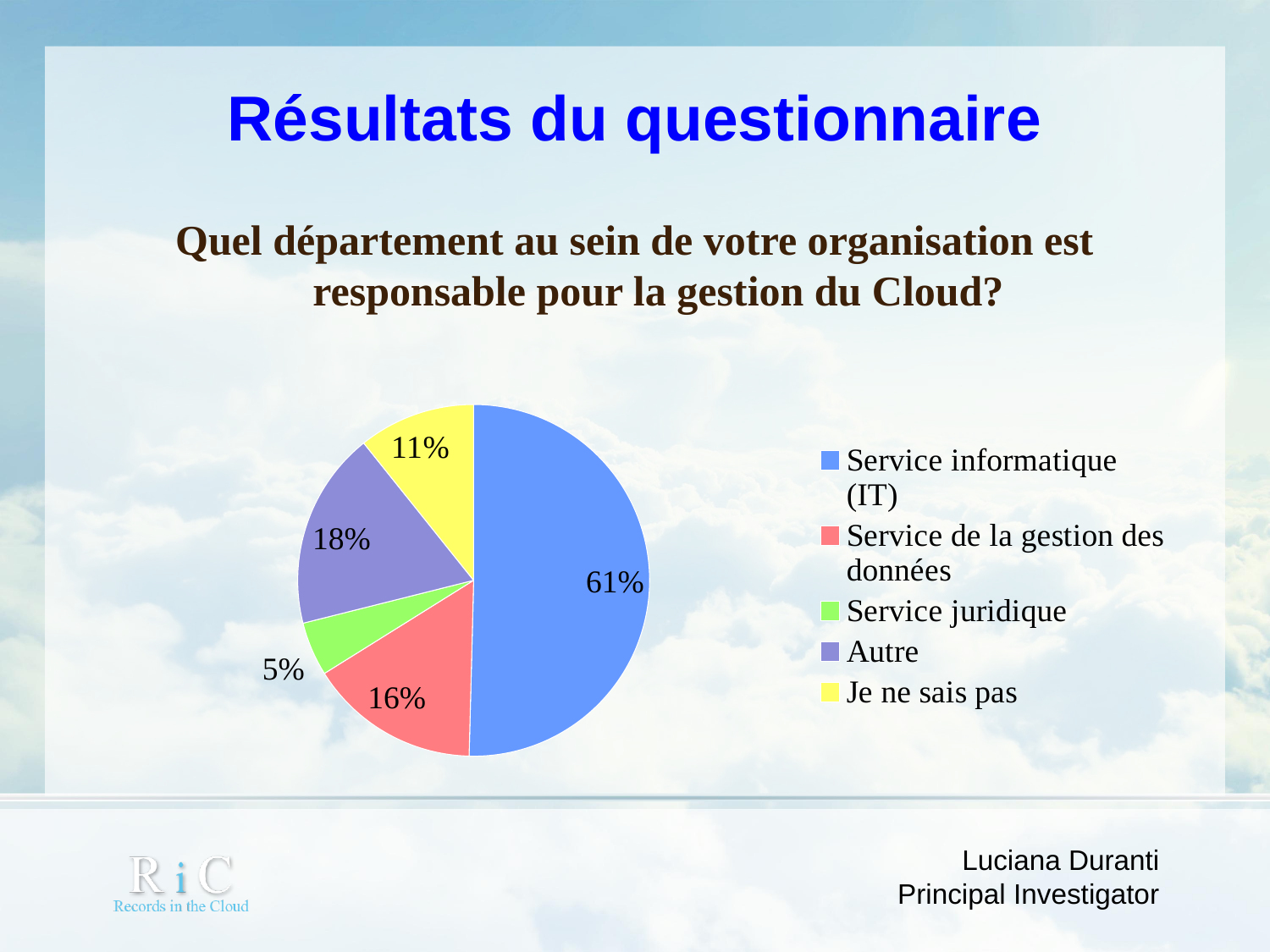
What share of the pie does Service informatique (IT) hold? 61% What is the value shown for Service juridique? 5% Which colour represents Je ne sais pas in the legend? Yellow Which category has the smallest slice of the pie? Service juridique What is the difference between the shares for Autre and Service de la gestion des données? 2% Which is larger, the share for Autre or the share for Je ne sais pas? Autre What is the value shown for Autre? 18% Which category has the largest slice of the pie? Service informatique (IT) What kind of chart is shown on the slide? Pie chart What is the value shown for Je ne sais pas? 11% What is the value shown for Service de la gestion des données? 16% How many categories does the pie chart show? 5